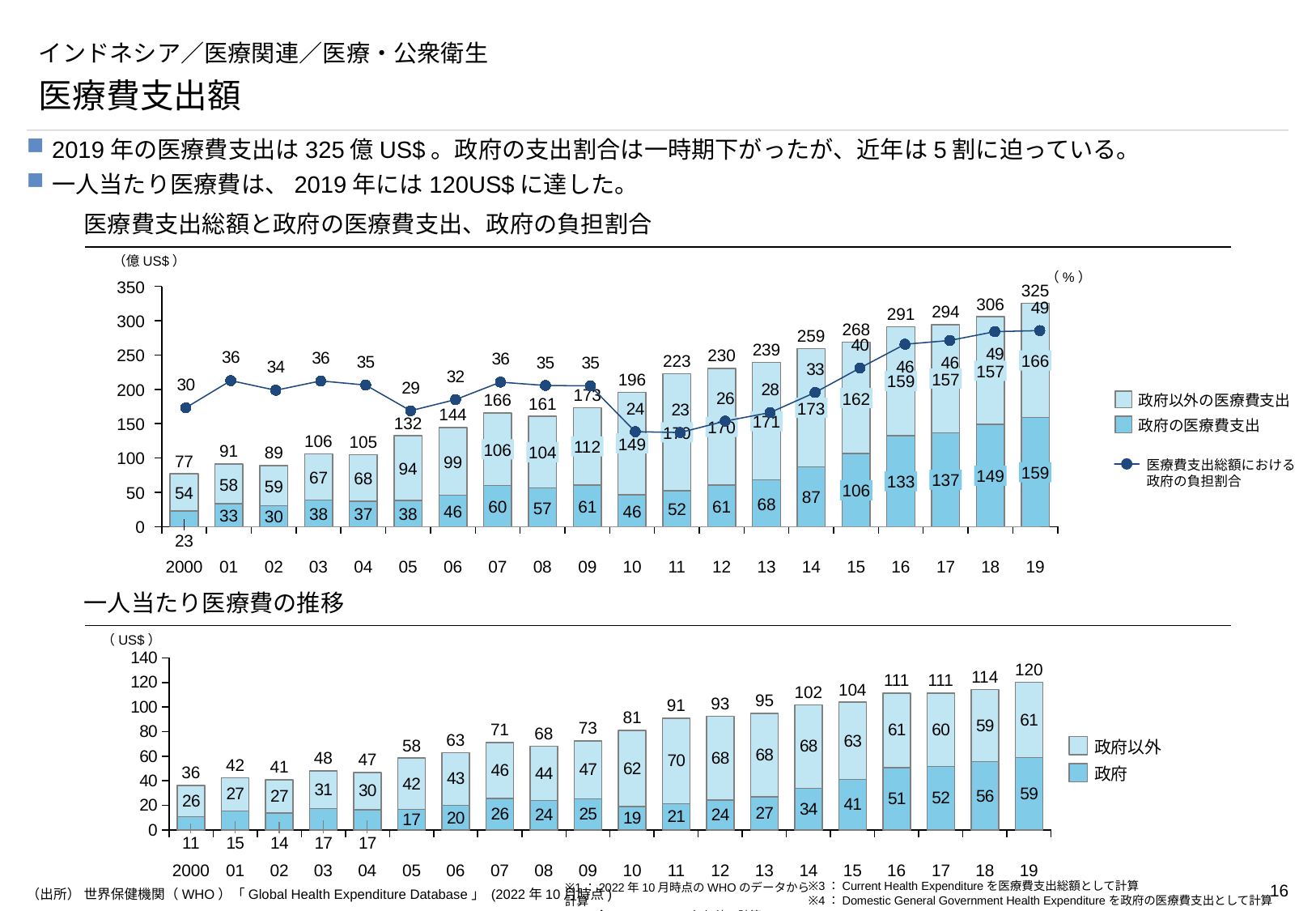
In the top chart (医療費支出総額と政府の医療費支出、政府の負担割合), is 政府の医療費支出 larger in 2014 or in 2015? 2015 In the bottom chart (一人当たり医療費の推移), what is the 政府 value for 2014? 34 In the top chart (医療費支出総額と政府の医療費支出、政府の負担割合), what is the value of 政府の医療費支出 for 2016? 133 In the top chart (医療費支出総額と政府の医療費支出、政府の負担割合), how many series does the legend list? 3 In the bottom chart (一人当たり医療費の推移), what is the total per-capita health expenditure for 2019? 120 In the bottom chart (一人当たり医療費の推移), how many years are shown on the x axis? 20 What kind of chart is the bottom chart (一人当たり医療費の推移)? Stacked bar chart In the top chart (医療費支出総額と政府の医療費支出、政府の負担割合), what is the difference between 政府以外の医療費支出 and 政府の医療費支出 in 2019? 7 In the top chart (医療費支出総額と政府の医療費支出、政府の負担割合), what is the total health expenditure for 2019? 325 In the bottom chart (一人当たり医療費の推移), which year has the highest total per-capita health expenditure? 2019 In the top chart (医療費支出総額と政府の医療費支出、政府の負担割合), what is the government share (政府の負担割合) for 2011? 23 In the top chart (医療費支出総額と政府の医療費支出、政府の負担割合), which year has the lowest total health expenditure? 2000